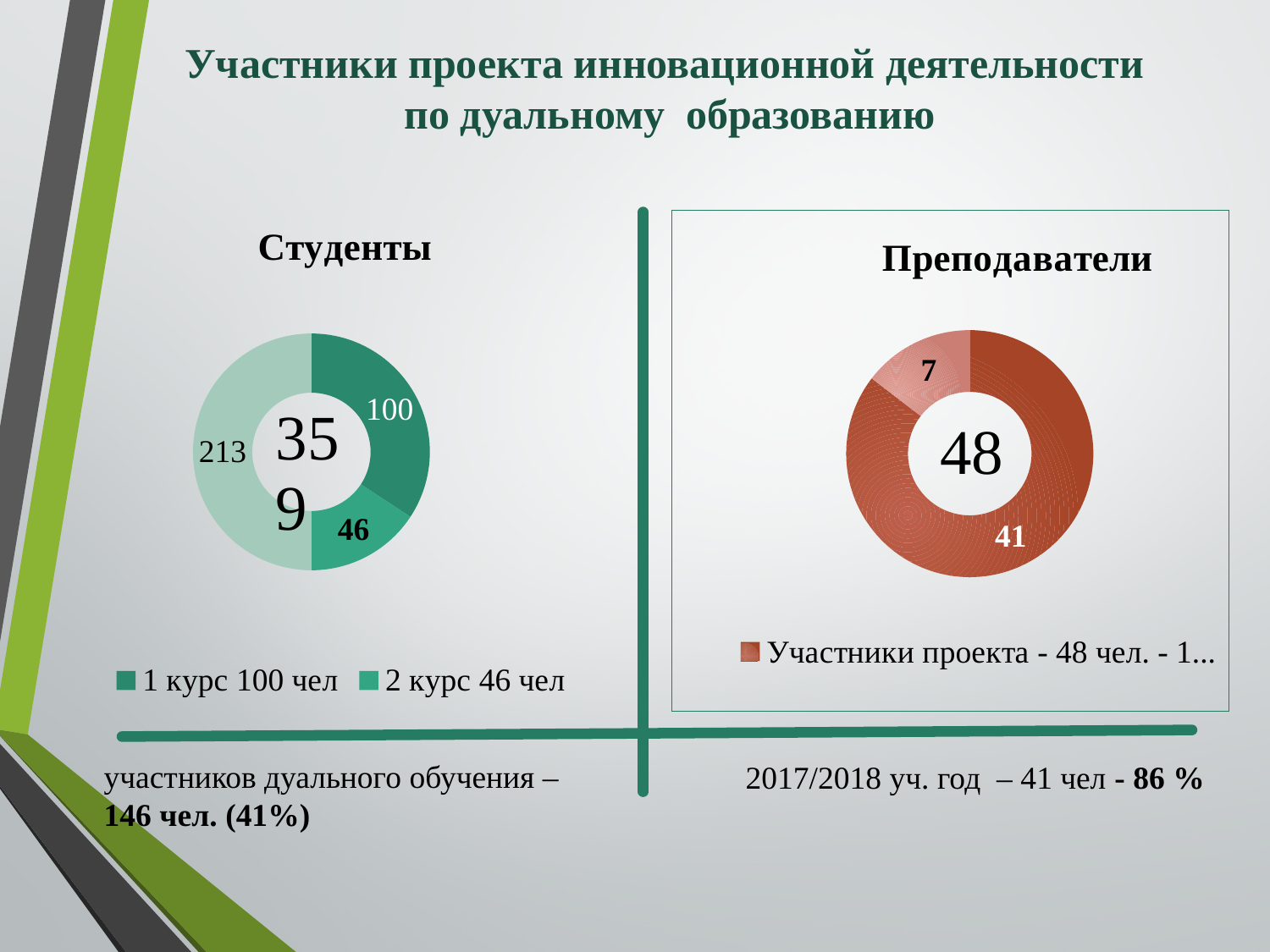
What kind of chart is the Студенты chart? doughnut chart How many entries does the legend of the Студенты chart list? 2 In the Студенты chart, what is the value labelled on the largest (light green) slice? 213 How many slices does the Преподаватели chart have? 2 What number is shown in the centre of the Преподаватели doughnut chart? 48 In the Преподаватели chart, what is the value of the larger slice? 41 In the Студенты chart, what is the total of the three slice values (100, 46 and 213)? 359 In the Студенты chart, what is the value for 2 курс? 46 In the Студенты chart, which legend category has the larger value, 1 курс or 2 курс? 1 курс In the Преподаватели chart, what is the difference between the two slice values (41 and 7)? 34 In the Студенты chart, what is the value for 1 курс? 100 In the Студенты chart, what is the difference between the values for 1 курс and 2 курс? 54